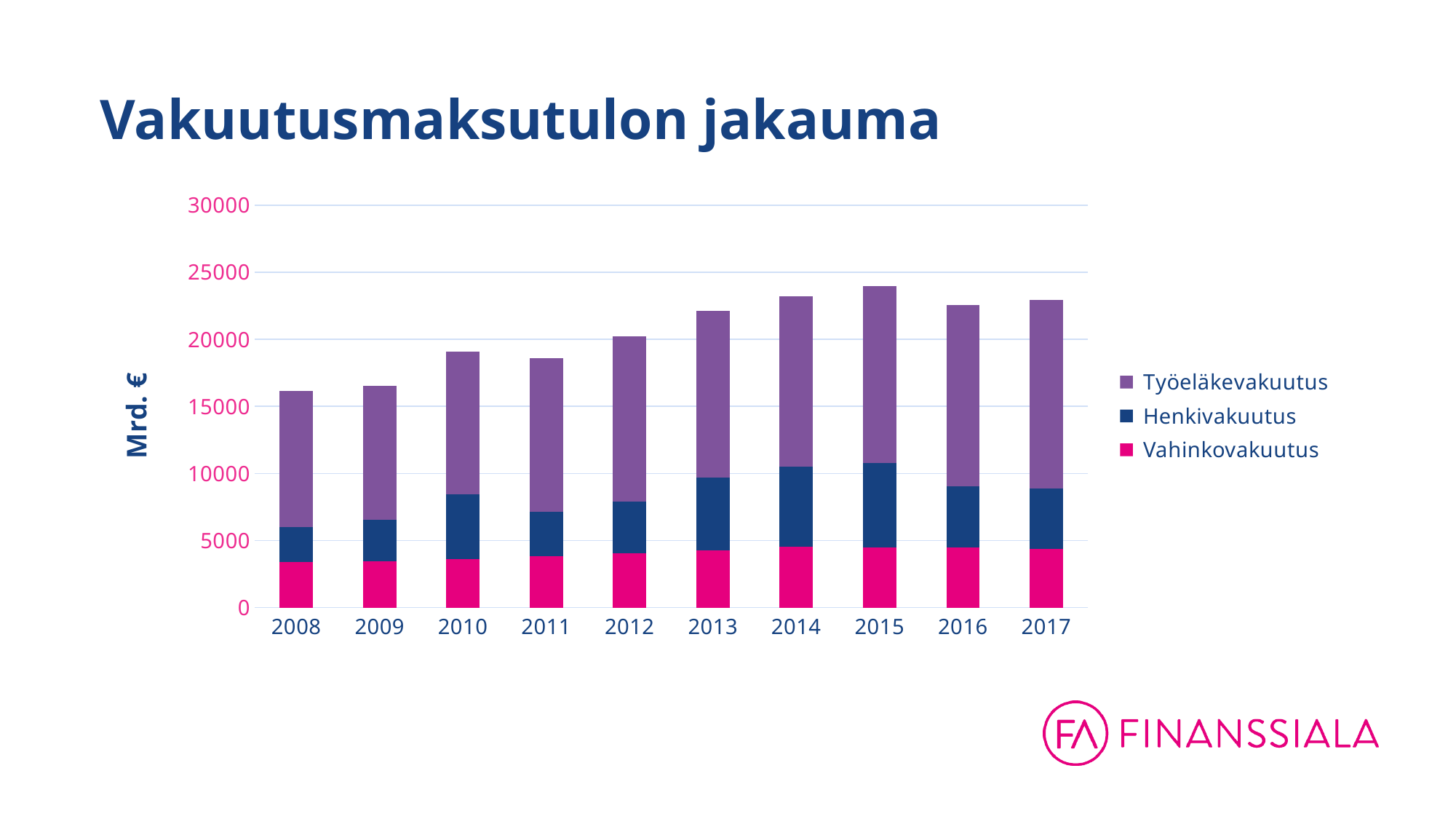
Which year has the highest total bar? 2015 What is the label on the vertical axis of the chart? Mrd. € Which is larger, the total bar for 2015 or the total bar for 2008? 2015 Do the total bars generally rise or fall from 2008 to 2015? rise Is the total bar for 2008 greater or less than 15000? greater Is the total bar for 2013 greater or less than 20000? greater Is the total bar for 2015 greater or less than 25000? less How many years are shown on the x axis of the chart? 10 How many series does the legend list? 3 What kind of chart is shown on the slide? Stacked bar chart